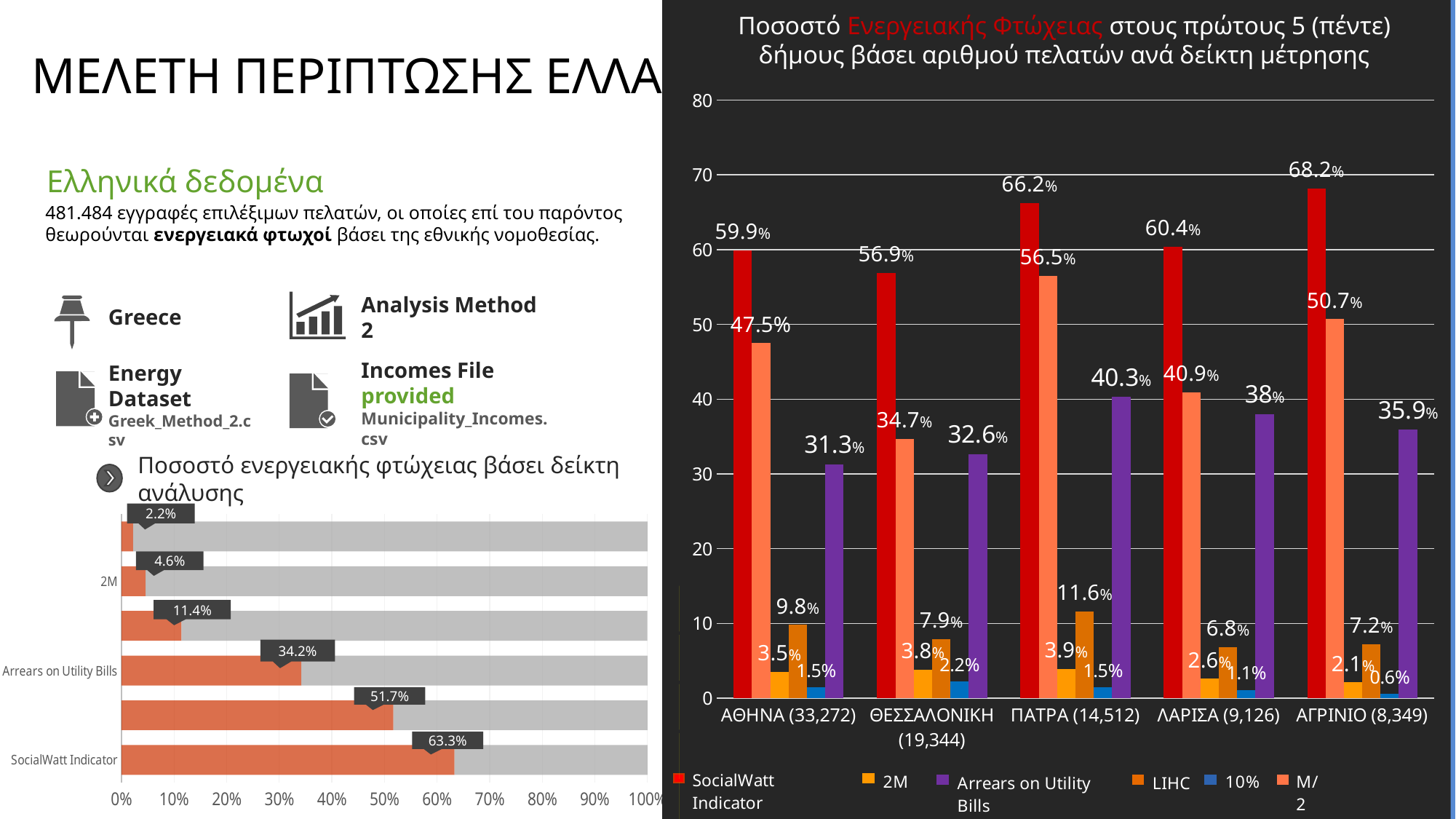
In the right-hand chart, what is the M/2 value for ΑΓΡΙΝΙΟ (8,349)? 50.7% How many municipalities are shown on the x axis of the right-hand chart? 5 In the left-hand chart, what is the value of the SocialWatt Indicator bar? 63.3% In the right-hand chart, which is larger: the LIHC value for ΑΘΗΝΑ (33,272) or the LIHC value for ΠΑΤΡΑ (14,512)? ΠΑΤΡΑ (14,512) In the left-hand chart, what is the value of the Arrears on Utility Bills bar? 34.2% In the right-hand chart, which municipality has the lowest 10% series value? ΑΓΡΙΝΙΟ (8,349) In the right-hand chart, what is the difference between the SocialWatt Indicator value and the M/2 value for ΘΕΣΣΑΛΟΝΙΚΗ (19,344)? 22.2% In the right-hand chart (Ποσοστό Ενεργειακής Φτώχειας στους πρώτους 5 δήμους), what is the SocialWatt Indicator value for ΠΑΤΡΑ (14,512)? 66.2% How many series does the legend of the right-hand chart list? 6 In the right-hand chart, what is the Arrears on Utility Bills value for ΛΑΡΙΣΑ (9,126)? 38% In the right-hand chart, which municipality has the highest SocialWatt Indicator value? ΑΓΡΙΝΙΟ (8,349) What kind of chart is the left-hand chart (Ποσοστό ενεργειακής φτώχειας βάσει δείκτη ανάλυσης)? Bar chart